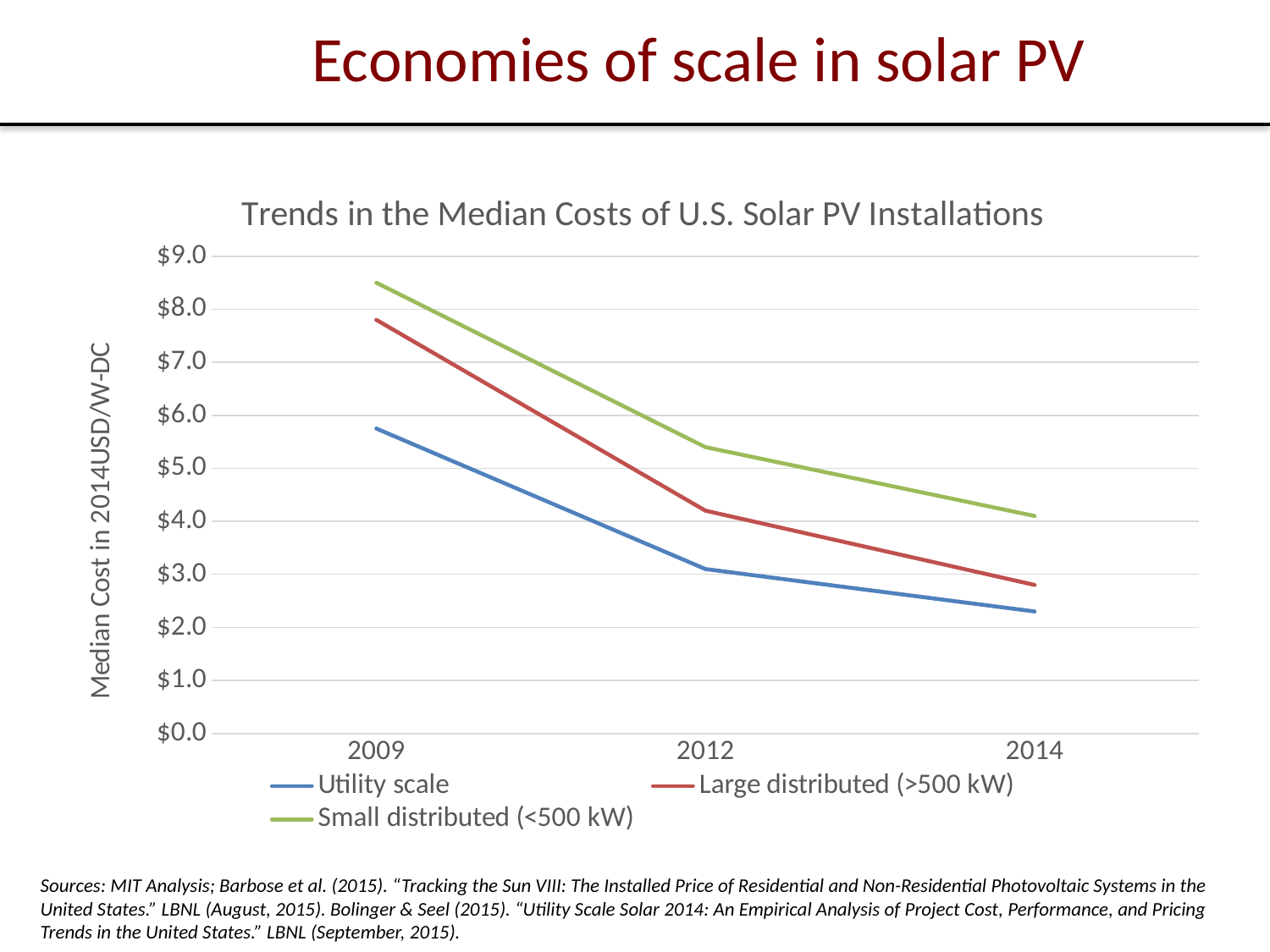
Which series has the highest median cost in 2009? Small distributed (<500 kW) Do the median costs for Utility scale rise or fall from 2009 to 2014? fall How many years are plotted along the x axis? 3 Is the value for Utility scale in 2012 greater or less than $4.0? less What is the label of the y axis? Median Cost in 2014USD/W-DC Is the value for Small distributed (<500 kW) in 2009 greater or less than $8.0? greater How many series does the legend list? 3 Which series has the lowest median cost in 2014? Utility scale Is the value for Large distributed (>500 kW) in 2014 greater or less than $3.0? less What is the title of the chart? Trends in the Median Costs of U.S. Solar PV Installations What kind of chart is shown on the slide? line chart In 2012, which is larger: the median cost for Large distributed (>500 kW) or for Utility scale? Large distributed (>500 kW)